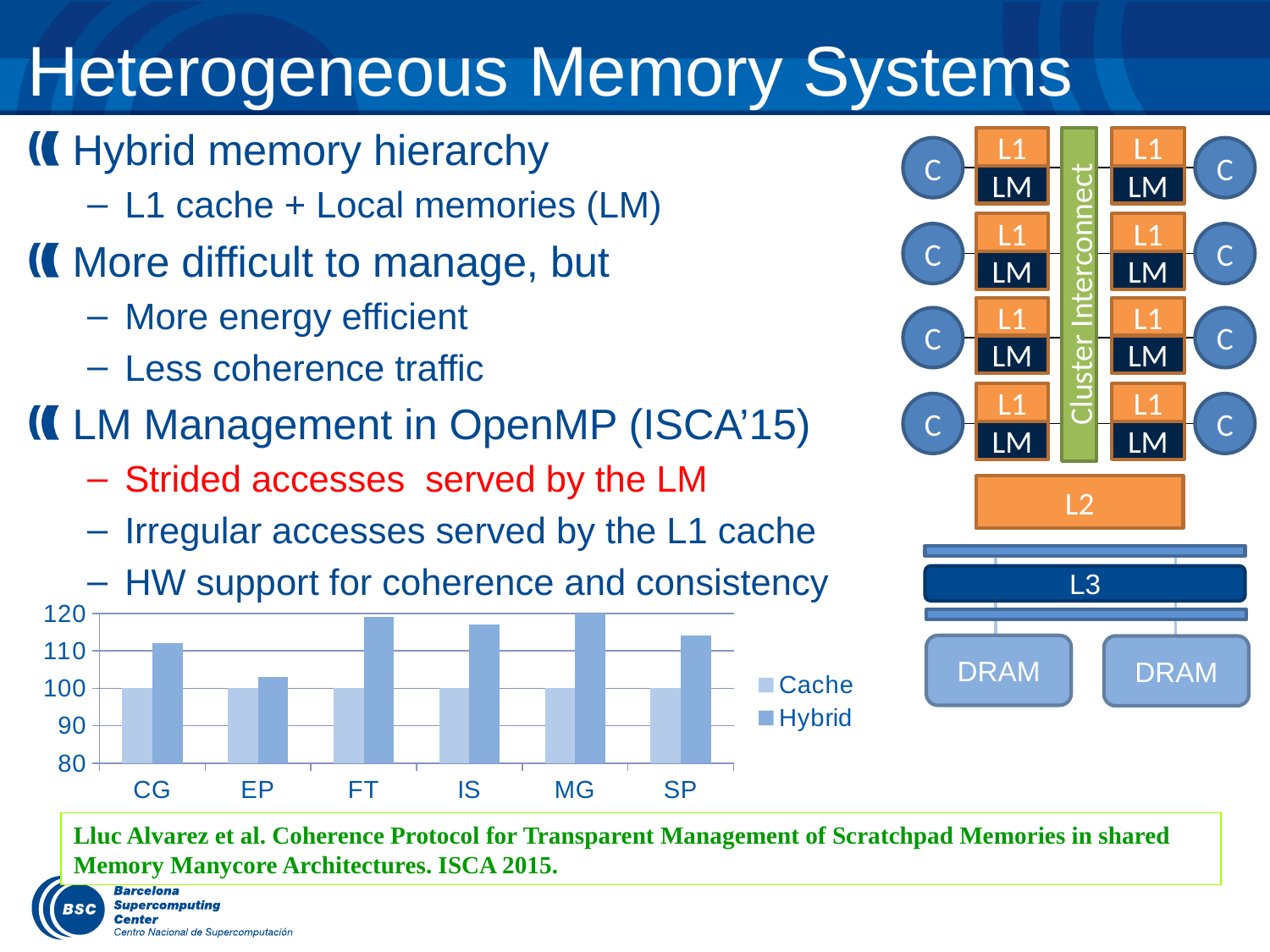
What is the value of the Cache bar for CG? 100 Is the Hybrid value for FT greater or less than 110? greater How many categories are shown on the x axis of the chart? 6 What kind of chart is shown on the slide? bar chart What is the value of the Cache bar for SP? 100 Is the Hybrid value for CG greater or less than 110? greater What are the two series named in the chart's legend? Cache and Hybrid Which category has the lowest Hybrid value? EP Which is larger, the Hybrid value for CG or the Hybrid value for EP? CG How many series does the chart's legend list? 2 Which is larger, the Hybrid value for FT or the Hybrid value for SP? FT Is the Hybrid value for EP greater or less than 110? less